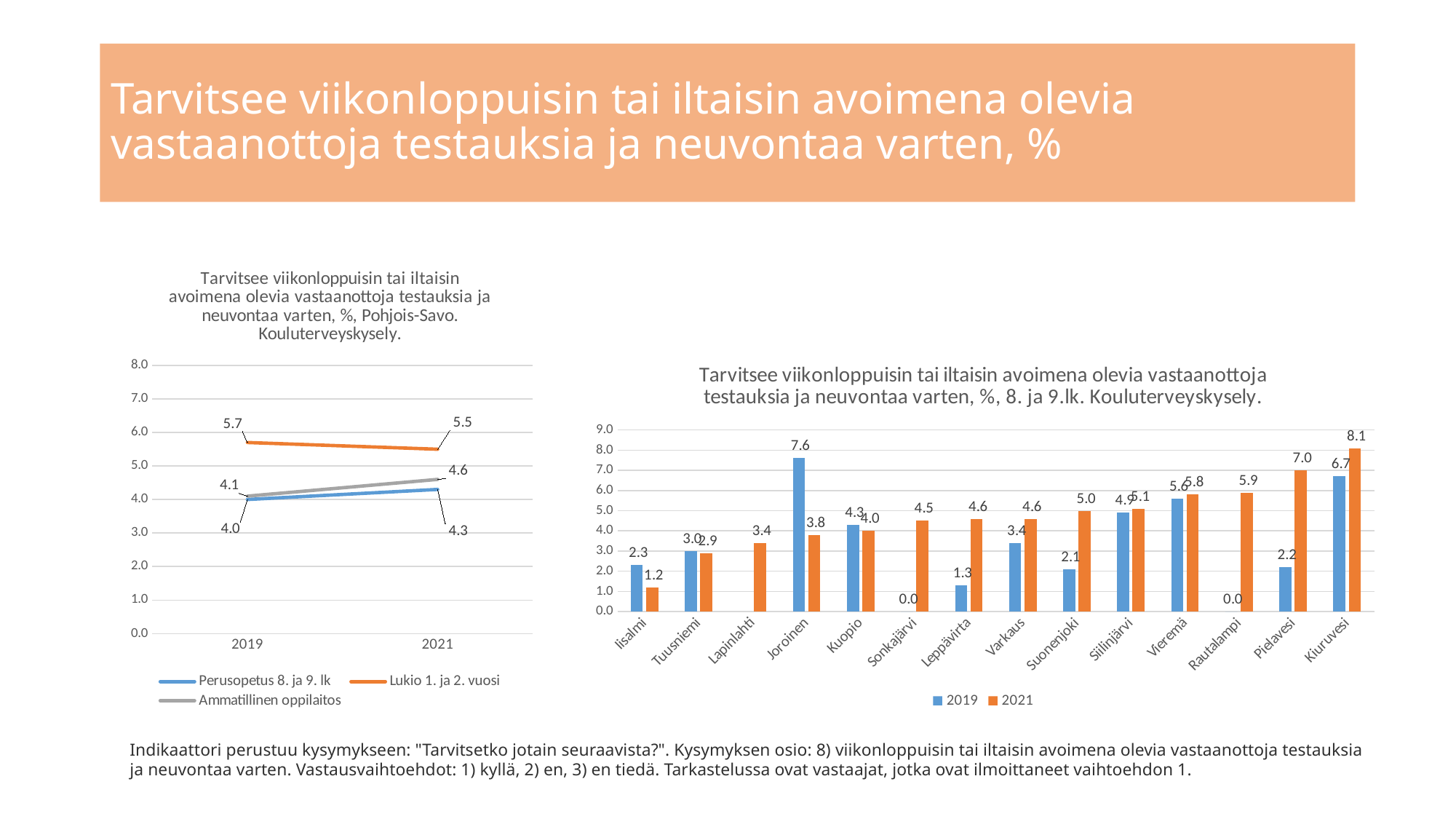
In the right chart (8. ja 9.lk by municipality), what is the difference between the 2019 and 2021 values for Joroinen? 3.8 In the left chart (Pohjois-Savo), what is the value for Lukio 1. ja 2. vuosi in 2019? 5.7 In the left chart (Pohjois-Savo), what is the difference between the Lukio 1. ja 2. vuosi value and the Perusopetus 8. ja 9. lk value in 2021? 1.2 In the right chart (8. ja 9.lk by municipality), which municipality has the highest 2019 value? Joroinen In the left chart (Pohjois-Savo), what is the value for Ammatillinen oppilaitos in 2021? 4.6 In the right chart (8. ja 9.lk by municipality), what is the 2021 value for Pielavesi? 7.0 What type of chart is the right chart (8. ja 9.lk by municipality)? bar chart In the left chart (Pohjois-Savo), did the value for Perusopetus 8. ja 9. lk rise or fall from 2019 to 2021? rise In the right chart (8. ja 9.lk by municipality), how many municipalities are shown on the x axis? 14 In the right chart (8. ja 9.lk by municipality), which municipality has the highest 2021 value? Kiuruvesi In the right chart (8. ja 9.lk by municipality), which municipality has the lowest 2021 value? Iisalmi In the left chart (Pohjois-Savo), how many series does the legend list? 3